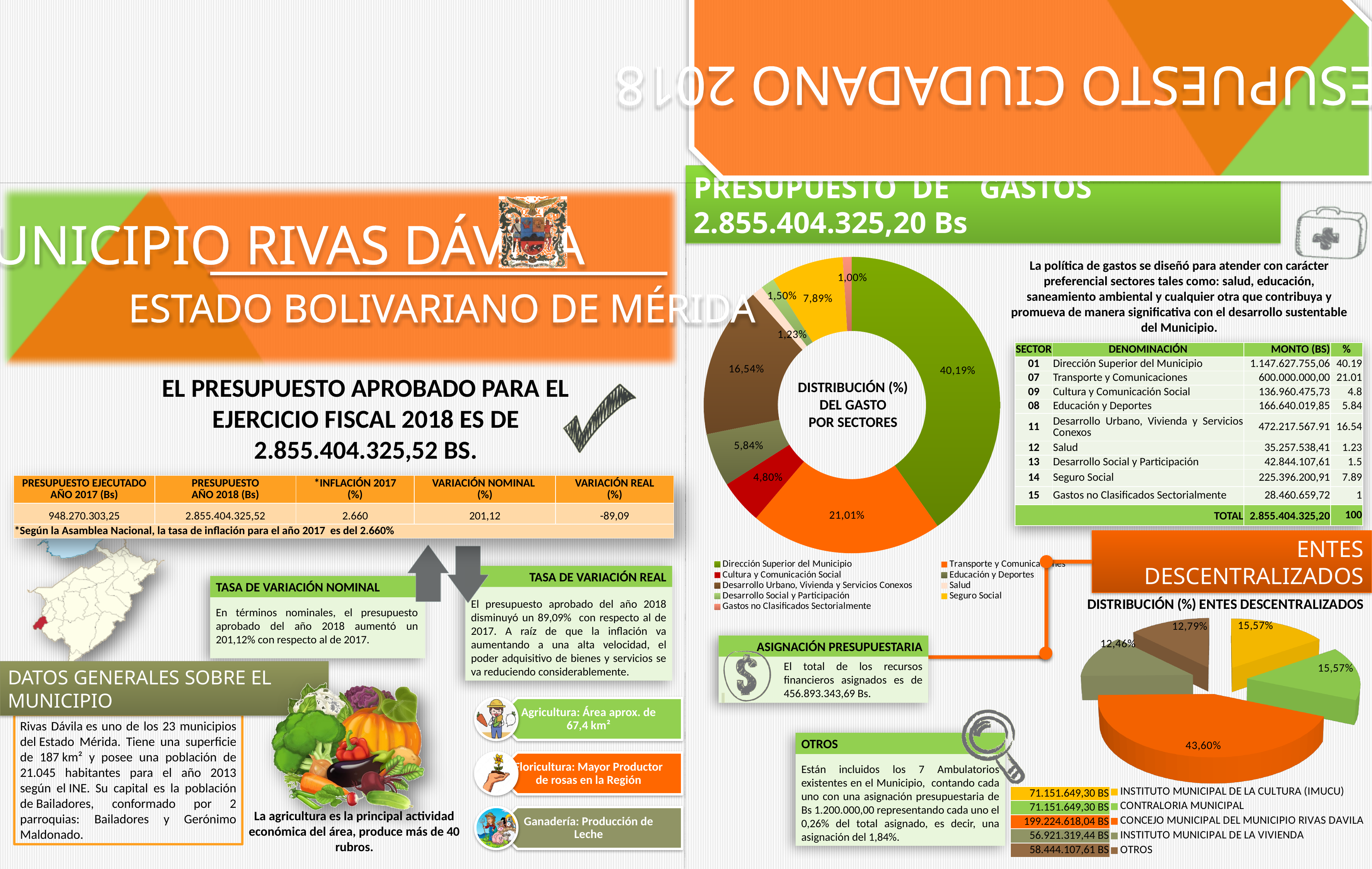
What kind of chart is 'DISTRIBUCIÓN (%) ENTES DESCENTRALIZADOS'? Pie chart In the 'DISTRIBUCIÓN (%) DEL GASTO POR SECTORES' chart, how many sectors does the legend list? 9 In the 'DISTRIBUCIÓN (%) DEL GASTO POR SECTORES' chart, what percentage is shown for Transporte y Comunicaciones? 21,01% In the 'DISTRIBUCIÓN (%) ENTES DESCENTRALIZADOS' chart, which entity has the largest share? Concejo Municipal del Municipio Rivas Dávila In the 'DISTRIBUCIÓN (%) DEL GASTO POR SECTORES' chart, which is larger: Educación y Deportes or Cultura y Comunicación Social? Educación y Deportes In the 'DISTRIBUCIÓN (%) DEL GASTO POR SECTORES' chart, what percentage is shown for Seguro Social? 7,89% In the 'DISTRIBUCIÓN (%) ENTES DESCENTRALIZADOS' chart, what percentage is shown for Concejo Municipal del Municipio Rivas Dávila? 43,60% In the 'DISTRIBUCIÓN (%) DEL GASTO POR SECTORES' chart, which sector has the smallest share? Gastos no Clasificados Sectorialmente In the 'DISTRIBUCIÓN (%) DEL GASTO POR SECTORES' chart, what percentage is shown for Dirección Superior del Municipio? 40,19% In the 'DISTRIBUCIÓN (%) ENTES DESCENTRALIZADOS' chart, how many entities does the legend list? 5 In the 'DISTRIBUCIÓN (%) DEL GASTO POR SECTORES' chart, which sector has the largest share? Dirección Superior del Municipio In the 'DISTRIBUCIÓN (%) DEL GASTO POR SECTORES' chart, what is the difference in percentage points between Dirección Superior del Municipio and Transporte y Comunicaciones? 19,18